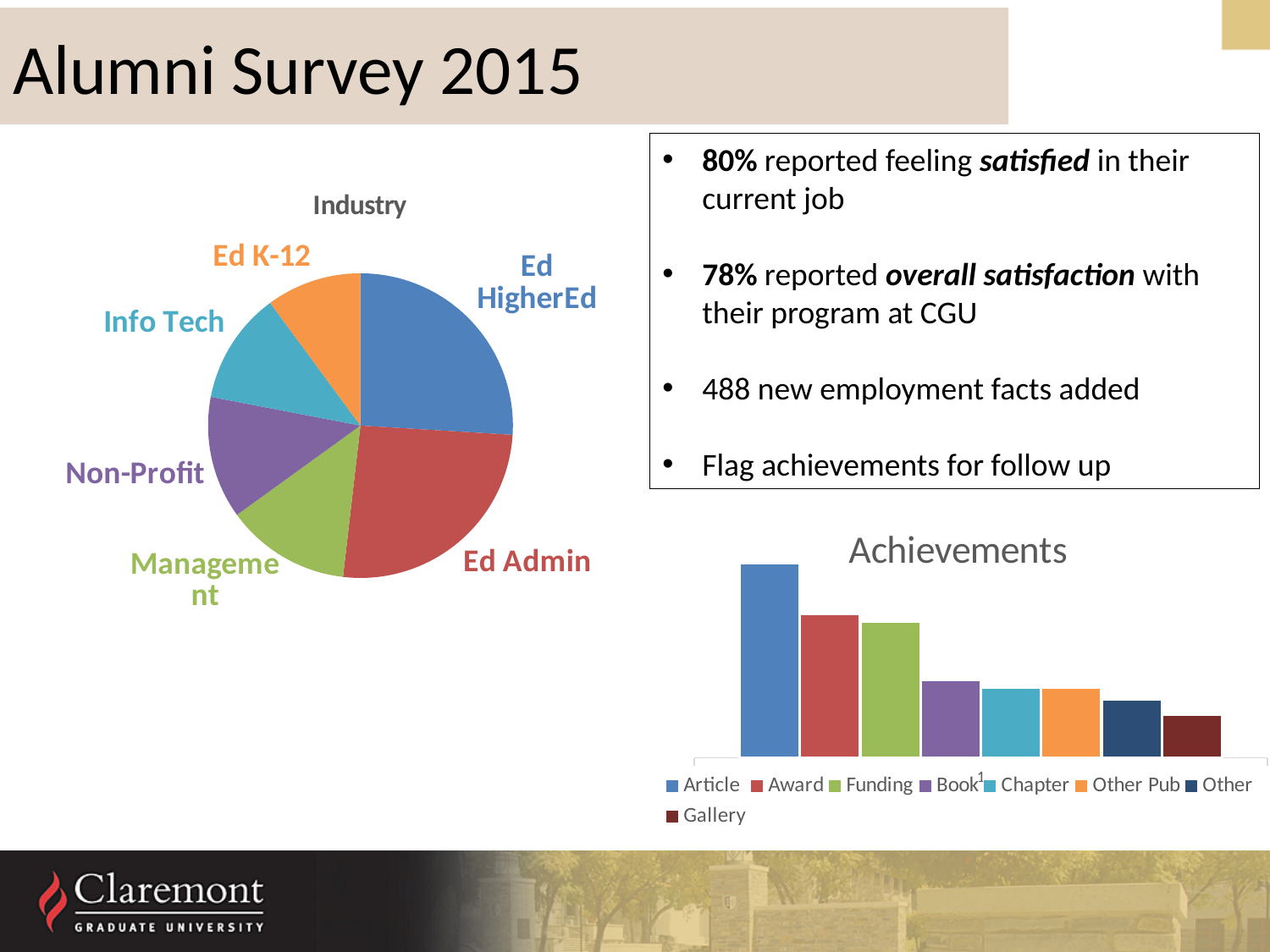
In the "Achievements" bar chart, how many bars are plotted? 8 In the "Industry" pie chart, which slice is larger, Ed HigherEd or Info Tech? Ed HigherEd In the "Industry" pie chart, how many slices are there? 6 In the "Achievements" bar chart, do the values rise or fall from left to right? fall In the "Achievements" bar chart, which is larger, Award or Book? Award In the "Achievements" bar chart, which category has the highest value? Article In the "Achievements" bar chart, which category has the lowest value? Gallery What is the title of the pie chart on the left of the slide? Industry In the "Achievements" bar chart, how many entries does the legend list? 8 What kind of chart is the "Industry" chart on the left of the slide? pie chart In the "Industry" pie chart, which slice is larger, Ed Admin or Ed K-12? Ed Admin What kind of chart is the "Achievements" chart on the right of the slide? bar chart